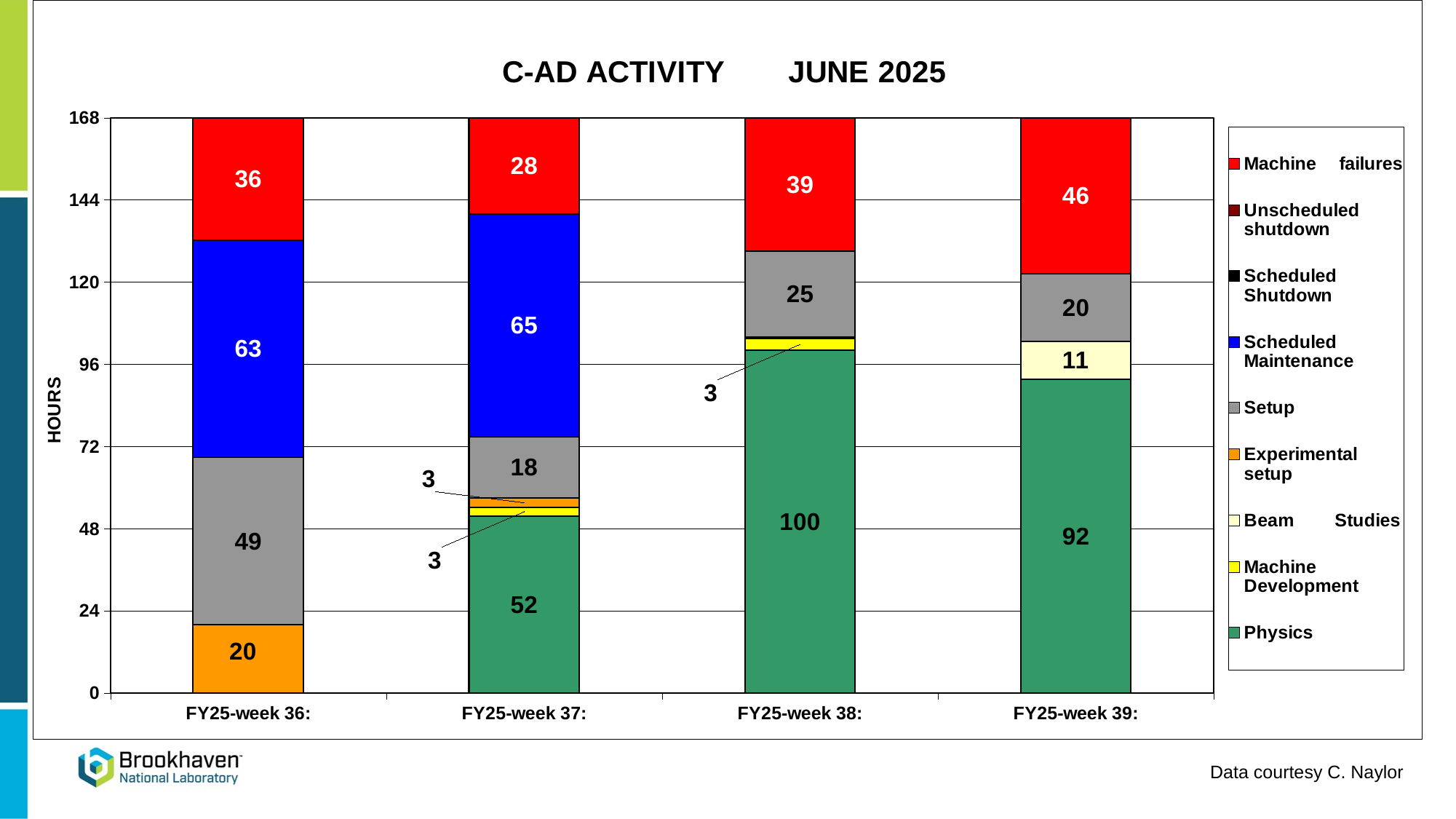
What is the difference between Scheduled Maintenance hours in FY25-week 37 and FY25-week 36? 2 How many hours of Physics are shown for FY25-week 38? 100 How many hours of Beam Studies are shown for FY25-week 39? 11 How many weeks (categories) are shown along the x axis? 4 Which week has the highest Machine failures value? FY25-week 39 What is the difference in Physics hours between FY25-week 38 and FY25-week 37? 48 Which week has more Setup hours, FY25-week 36 or FY25-week 38? FY25-week 36 How many hours of Machine failures are shown for FY25-week 39? 46 What is the title of the y axis? HOURS Which week has the lowest Machine failures value? FY25-week 37 What kind of chart is shown on the slide? Stacked bar chart How many series does the legend list? 9